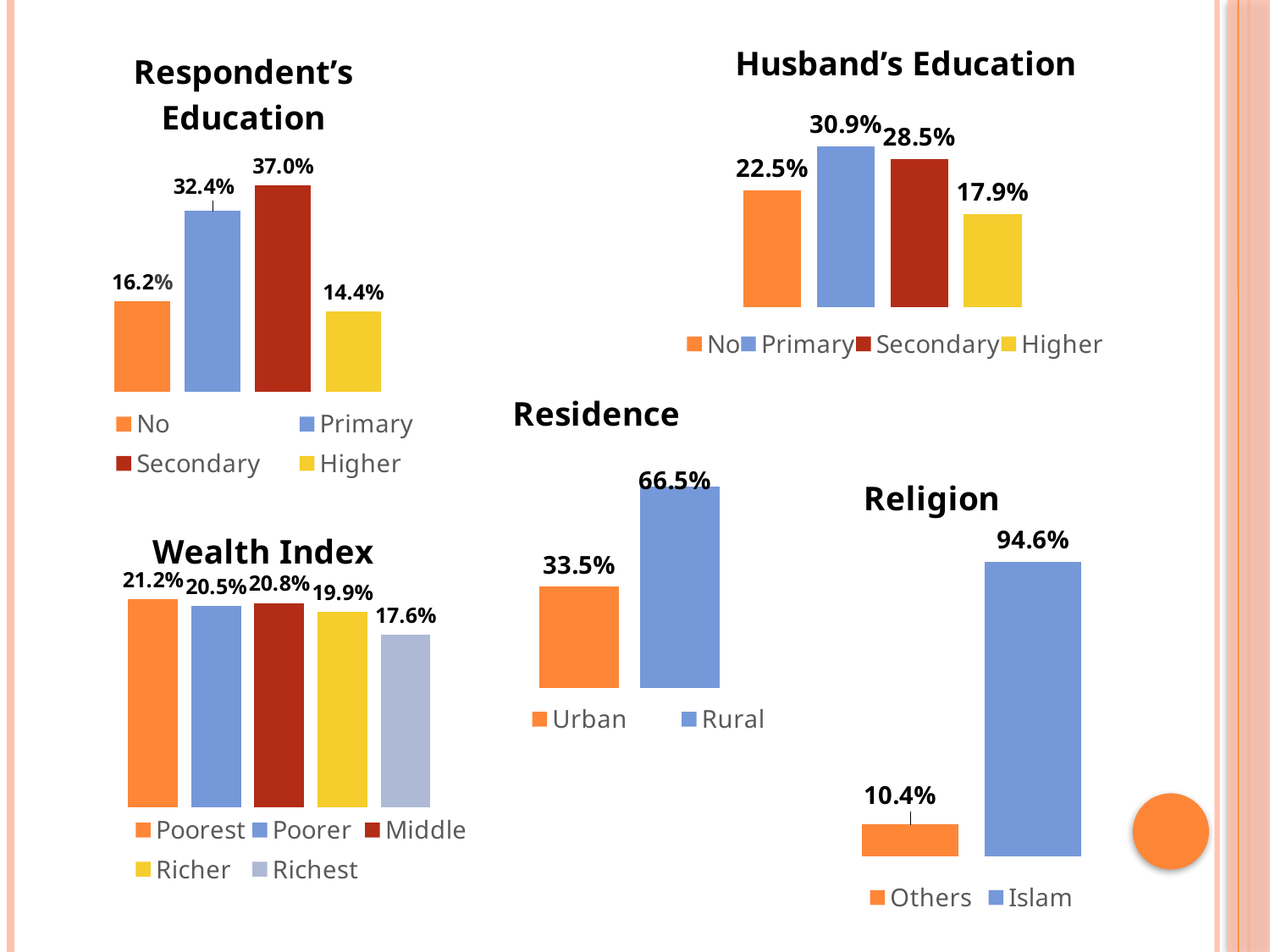
In the Wealth Index chart, what is the value for Richest? 17.6% In the Religion chart, what is the value for Islam? 94.6% What kind of chart is the Religion chart? Bar chart In the Residence chart, which is larger, Urban or Rural? Rural In the Respondent's Education chart, what is the value for Secondary? 37.0% In the Husband's Education chart, what is the value for No education? 22.5% In the Wealth Index chart, how many categories are plotted? 5 In the Respondent's Education chart, which category has the lowest value? Higher In the Husband's Education chart, which category has the highest value? Primary In the Residence chart, what is the difference between Rural and Urban? 33.0% How many entries does the legend of the Wealth Index chart list? 5 In the Husband's Education chart, what is the difference between Secondary and Higher? 10.6%